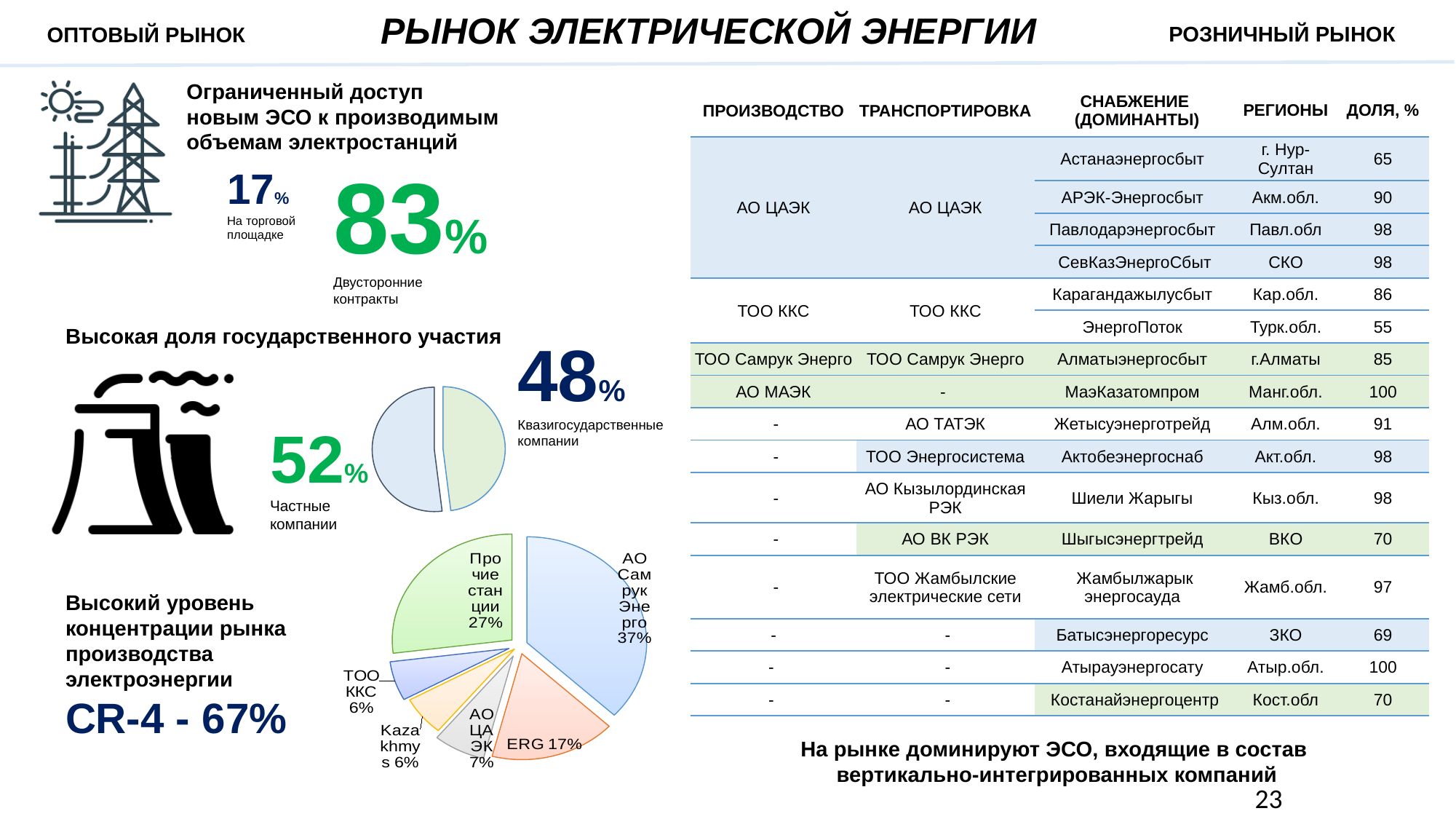
In the upper pie chart on the left, what share do Квазигосударственные компании hold? 48% In the lower pie chart on the left, which producer has the largest slice? АО Самрук Энерго In the lower pie chart on the left (electricity production market concentration), what share does АО Самрук Энерго hold? 37% In the lower pie chart on the left, what share does ERG hold? 17% In the lower pie chart on the left, how many slices are there? 6 In the upper pie chart on the left, which group has the larger share: Частные компании or Квазигосударственные компании? Частные компании In the lower pie chart on the left, what share does АО ЦАЭК hold? 7% In the upper pie chart on the left (state participation), what share do Частные компании hold? 52% What type of chart is used to show the electricity production market concentration on the left of the slide? Pie chart In the lower pie chart on the left, by how many percentage points does АО Самрук Энерго exceed ERG? 20 percentage points In the lower pie chart on the left, what share do Прочие станции hold? 27% In the lower pie chart on the left, which is larger: ERG or АО ЦАЭК? ERG